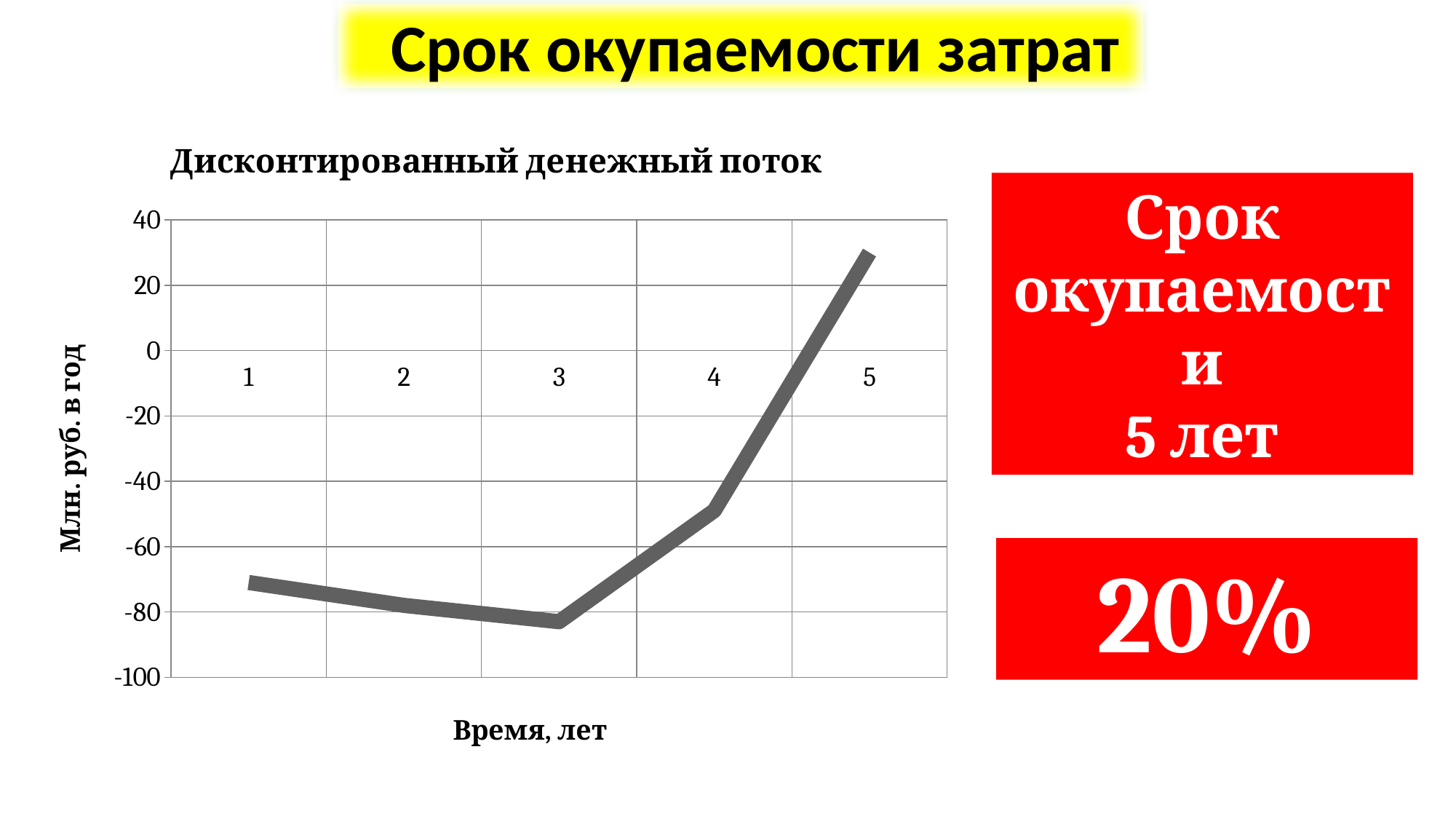
Is the value for year 3 greater or less than -60? less What kind of chart is shown under the title "Дисконтированный денежный поток"? line chart How many years (points) are plotted on the x axis of the chart? 5 What is the title of the chart? Дисконтированный денежный поток Is the value for year 5 greater or less than 20? greater In which year does the discounted cash flow reach its highest value? 5 Which is larger, the value for year 4 or the value for year 3? year 4 Is the value for year 4 greater or less than -40? less Do the values rise or fall from year 3 to year 5? rise What is the label of the y axis of the chart? Млн. руб. в год In which year does the discounted cash flow reach its lowest value? 3